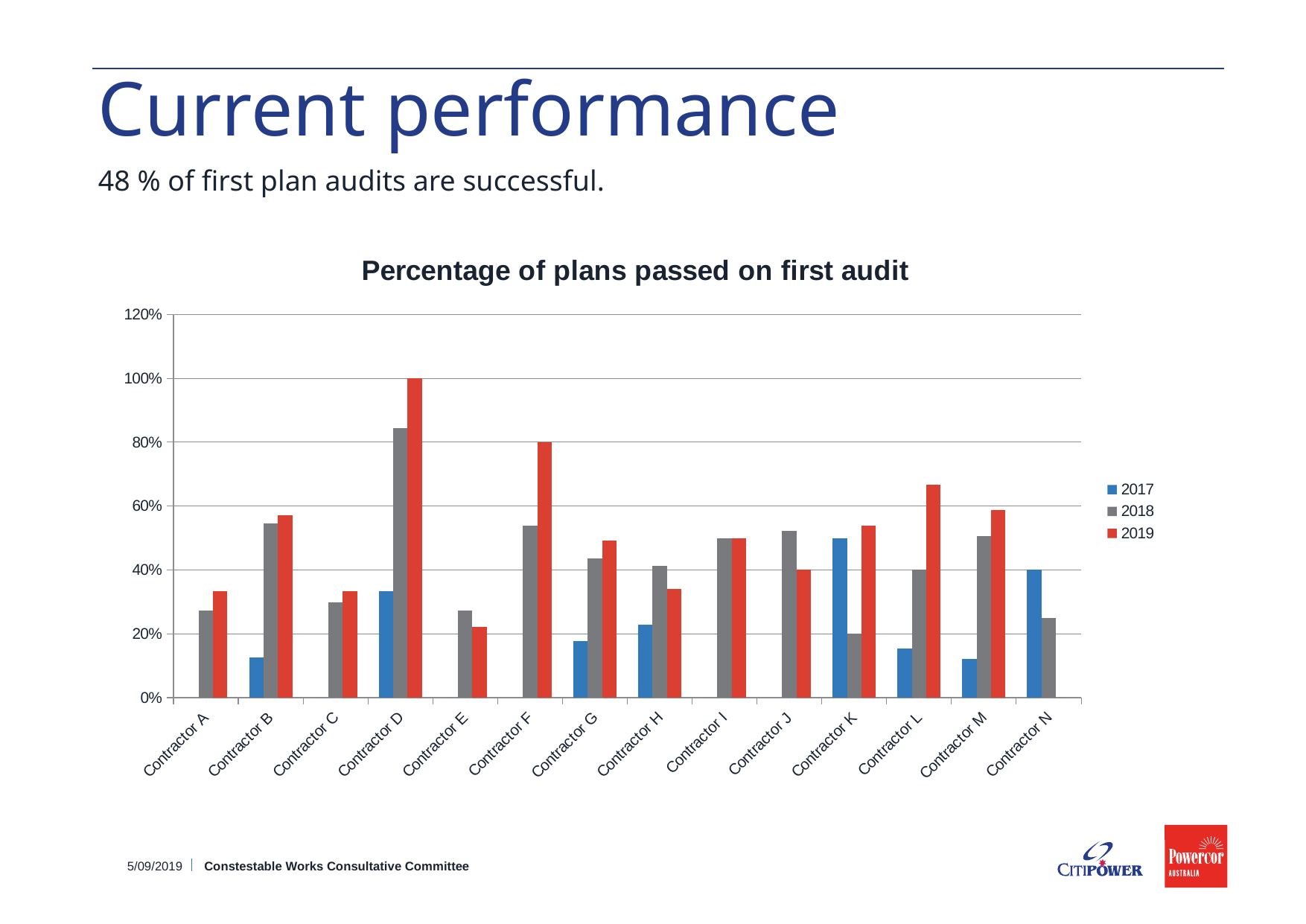
What kind of chart is shown on the slide? bar chart Which contractor has the highest 2019 value? Contractor D What is the title of the chart? Percentage of plans passed on first audit For Contractor L, which is larger: the 2018 value or the 2019 value? 2019 Which contractor has the lowest 2018 value? Contractor K Is the 2017 value for Contractor B greater or less than 20%? less What is the 2019 value for Contractor D? 100% Is the 2018 value for Contractor D greater or less than 80%? greater How many contractors are shown on the x axis? 14 What is the 2019 value for Contractor F? 80% What is the 2017 value for Contractor N? 40% How many series does the legend list? 3